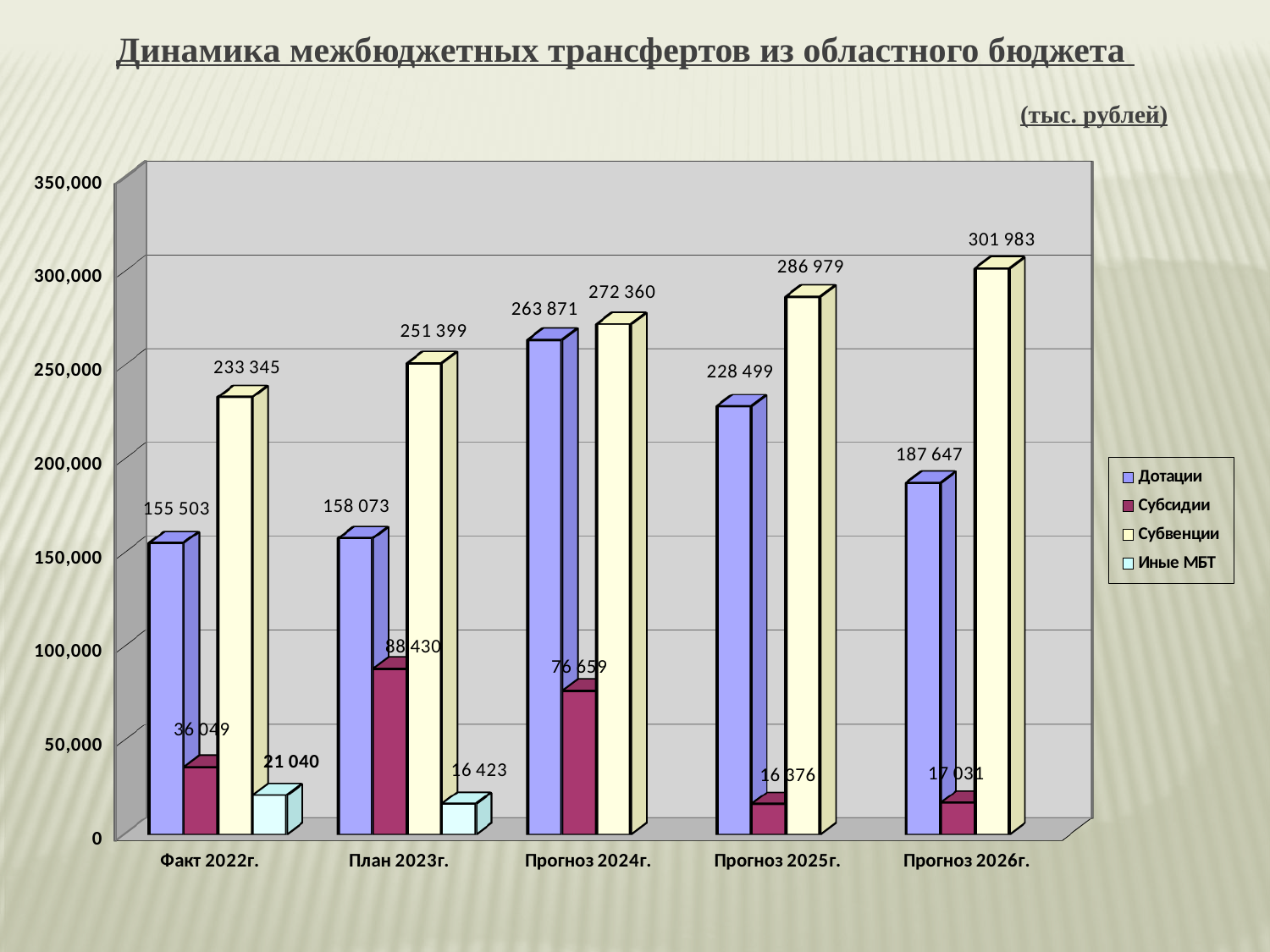
Do the Субвенции values rise or fall from Факт 2022г. to Прогноз 2026г.? Rise In which category is the Субсидии value lowest? Прогноз 2025г. How many categories are shown on the x axis? 5 What is the value of Иные МБТ for Факт 2022г.? 21 040 What is the value of Субсидии for План 2023г.? 88 430 What kind of chart is shown on the slide? Bar chart Which is larger: Дотации for Прогноз 2025г. or Субвенции for Прогноз 2025г.? Субвенции for Прогноз 2025г. What is the value of Субвенции for Прогноз 2026г.? 301 983 In which category is the Дотации value highest? Прогноз 2024г. How many series does the legend list? 4 What is the value of Дотации for Факт 2022г.? 155 503 What is the difference between the Субвенции values for Прогноз 2026г. and Факт 2022г.? 68 638